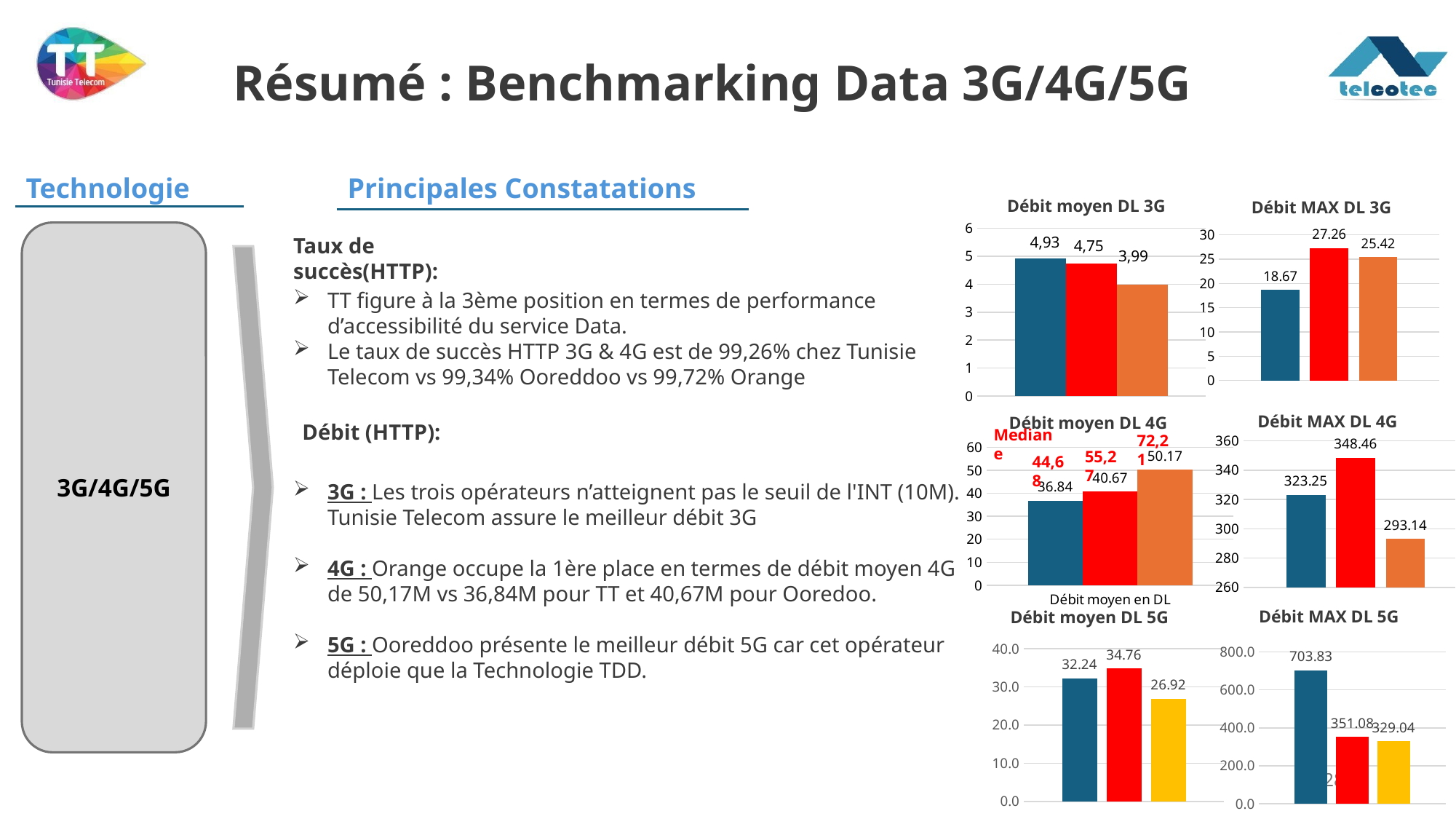
In the 'Débit moyen DL 3G' chart, which bar is the lowest? The third (orange) bar, 3,99 How many bars are plotted in the 'Débit moyen DL 4G' chart? 3 In the 'Débit MAX DL 4G' chart, what is the value of the third (orange) bar? 293.14 In the 'Débit moyen DL 4G' chart, do the bar values rise or fall from left to right? Rise In the 'Débit MAX DL 5G' chart, what is the difference between the first bar (703.83) and the second bar (351.08)? 352.75 In the 'Débit MAX DL 3G' chart, is the value of the first (blue) bar greater or less than 20? less In the 'Débit MAX DL 3G' chart, which bar is the highest? The second (red) bar, 27.26 In the 'Débit moyen DL 5G' chart, what is the value of the third (yellow) bar? 26.92 In the 'Débit moyen DL 5G' chart, which is larger: the first (blue) bar or the second (red) bar? The second (red) bar, 34.76 In the 'Débit moyen DL 3G' chart, what is the value of the first (blue) bar? 4,93 What type of chart is 'Débit MAX DL 5G'? Bar chart How many charts are shown on the slide? 6